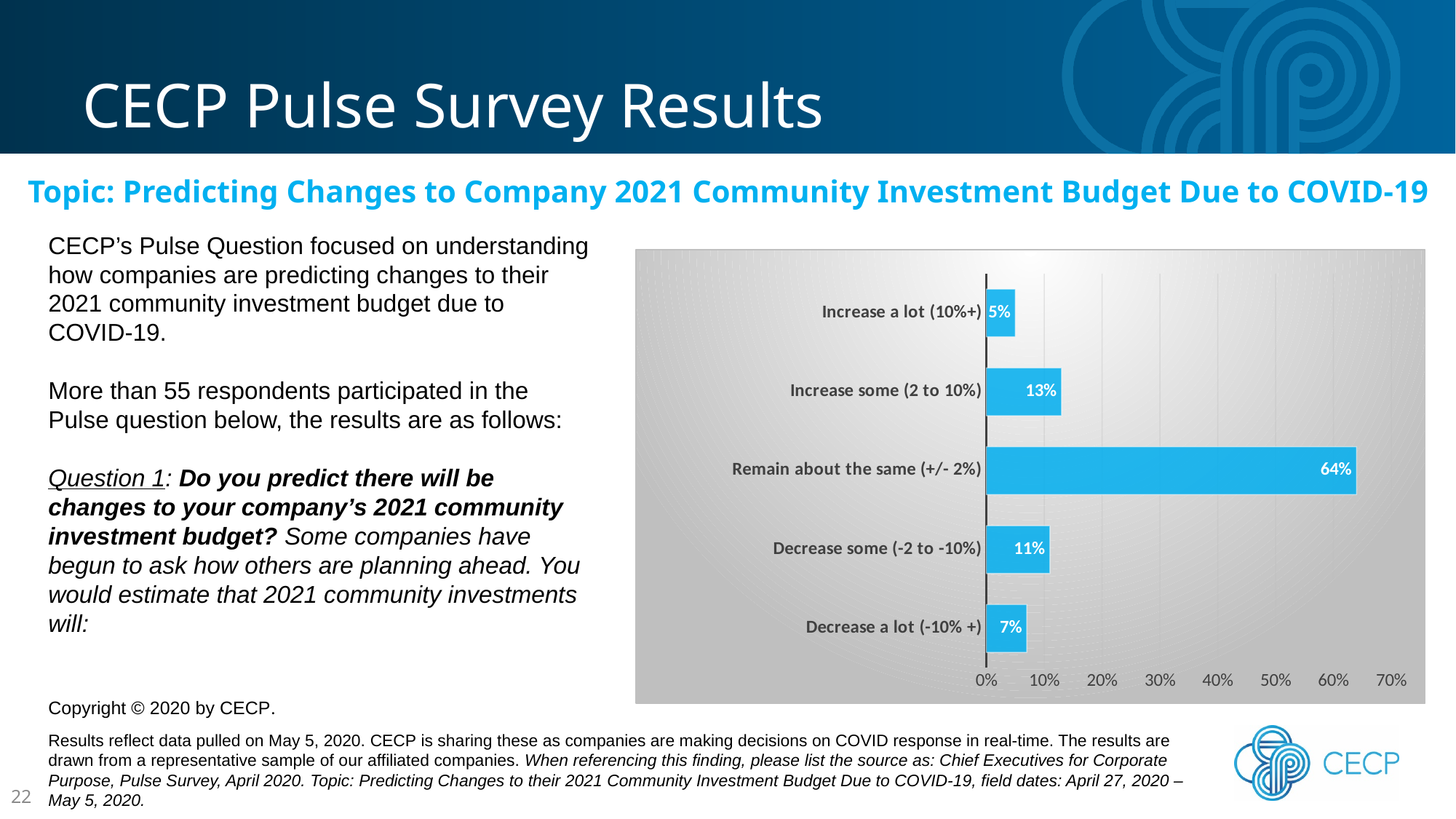
What percentage of respondents predict their budget will increase some (2 to 10%)? 13% What is the difference in percentage points between 'Remain about the same (+/- 2%)' and 'Increase some (2 to 10%)'? 51 percentage points What is the maximum value shown on the horizontal axis of the chart? 70% Which response category has the lowest percentage? Increase a lot (10%+) What is the combined percentage of respondents predicting any increase (a lot or some)? 18% Is the value for 'Remain about the same (+/- 2%)' greater or less than 60%? greater How many response categories are shown in the chart? 5 What percentage of respondents predict their 2021 community investment budget will remain about the same (+/- 2%)? 64% What percentage of respondents predict their budget will decrease a lot (-10% +)? 7% Which is larger: the percentage for 'Decrease some (-2 to -10%)' or 'Decrease a lot (-10% +)'? Decrease some (-2 to -10%) What type of chart is used to display the survey results? Bar chart Which response category has the highest percentage? Remain about the same (+/- 2%)